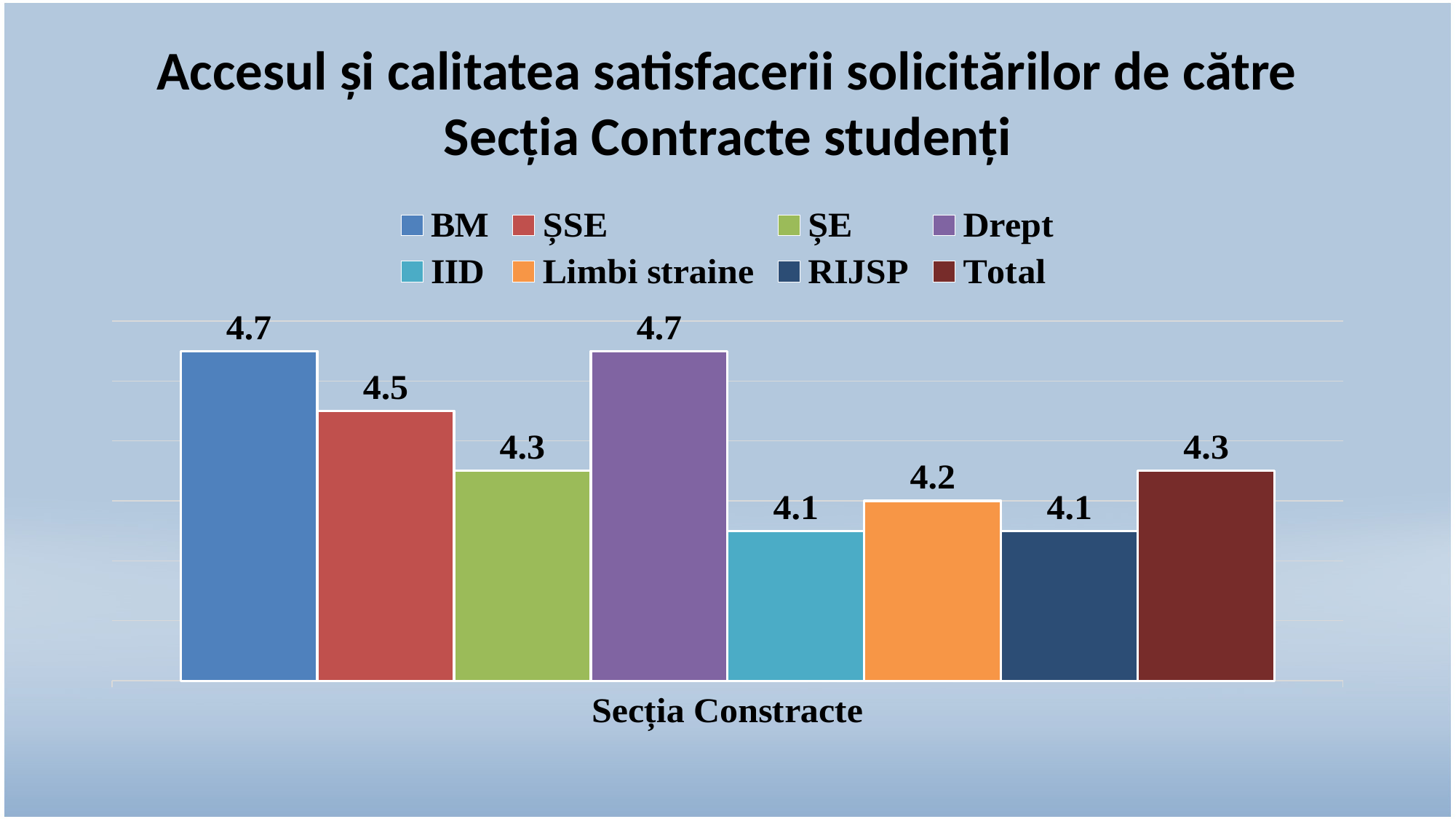
What is the value for ȘSE? 4.5 What is the highest value shown on the chart? 4.7 How many series does the legend list? 8 What kind of chart is shown on the slide? Bar chart What is the lowest value shown on the chart? 4.1 What is the label shown on the x axis below the bars? Secția Constracte What is the value for Limbi straine? 4.2 What is the value for Total? 4.3 What is the value for BM? 4.7 What is the value for RIJSP? 4.1 Which is larger, the value for ȘSE or the value for ȘE? ȘSE What is the difference between the values for BM and IID? 0.6